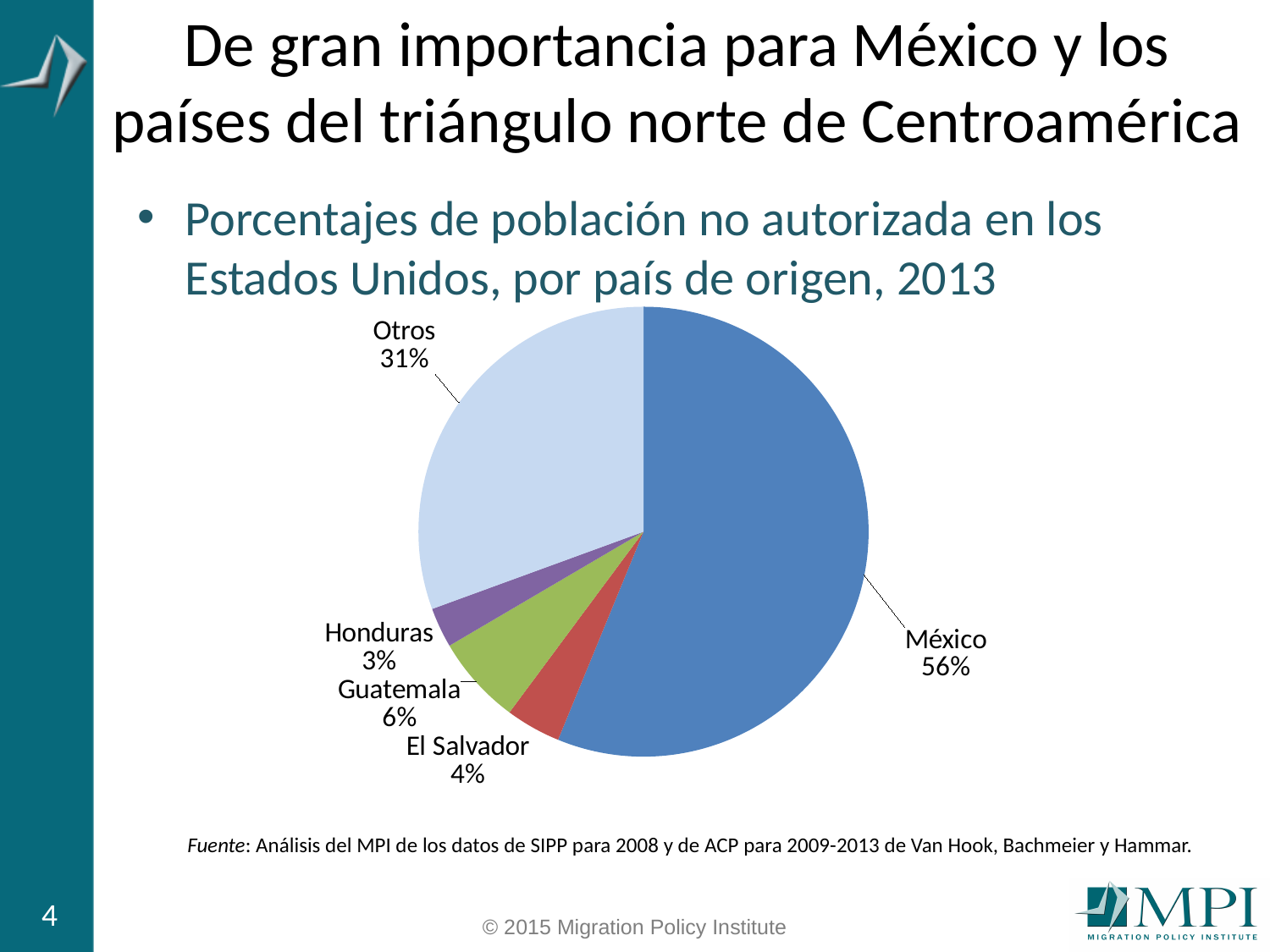
What percentage is shown for Otros? 31% What kind of chart is shown on the slide? pie chart What is the combined percentage for Guatemala, El Salvador and Honduras? 13% What percentage is shown for Honduras? 3% Which country of origin has the largest slice of the pie? México Which labelled category has the smallest slice of the pie? Honduras What percentage is shown for Guatemala? 6% What is the difference in percentage points between México and Otros? 25 Which is larger, the share for Guatemala or the share for El Salvador? Guatemala How many slices does the pie chart have? 5 What percentage of the unauthorized population is from México? 56% What percentage is shown for El Salvador? 4%